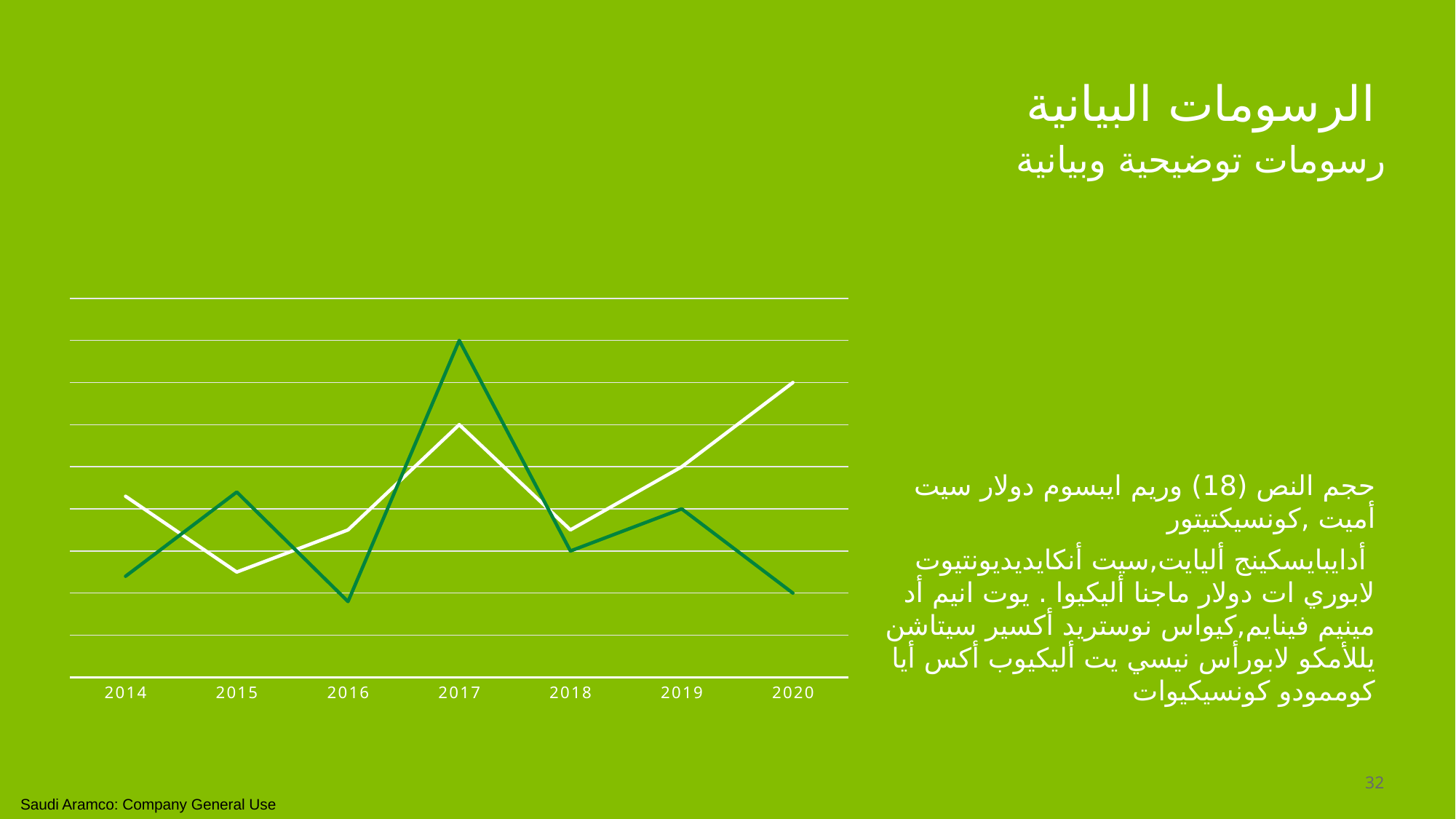
At 2014, which line is higher, the white line or the dark green line? white line In which year does the white line reach its highest point? 2020 What is the first year shown on the x axis? 2014 How many years are labelled on the x axis of the chart? 7 What kind of chart is shown on the slide? line chart Does the dark green line rise or fall from 2019 to 2020? fall How many lines are plotted on the chart? 2 In which year does the dark green line reach its highest point? 2017 What is the last year shown on the x axis? 2020 In which year does the white line reach its lowest point? 2015 At 2017, which line is higher, the white line or the dark green line? dark green line Does the white line rise or fall from 2018 to 2020? rise